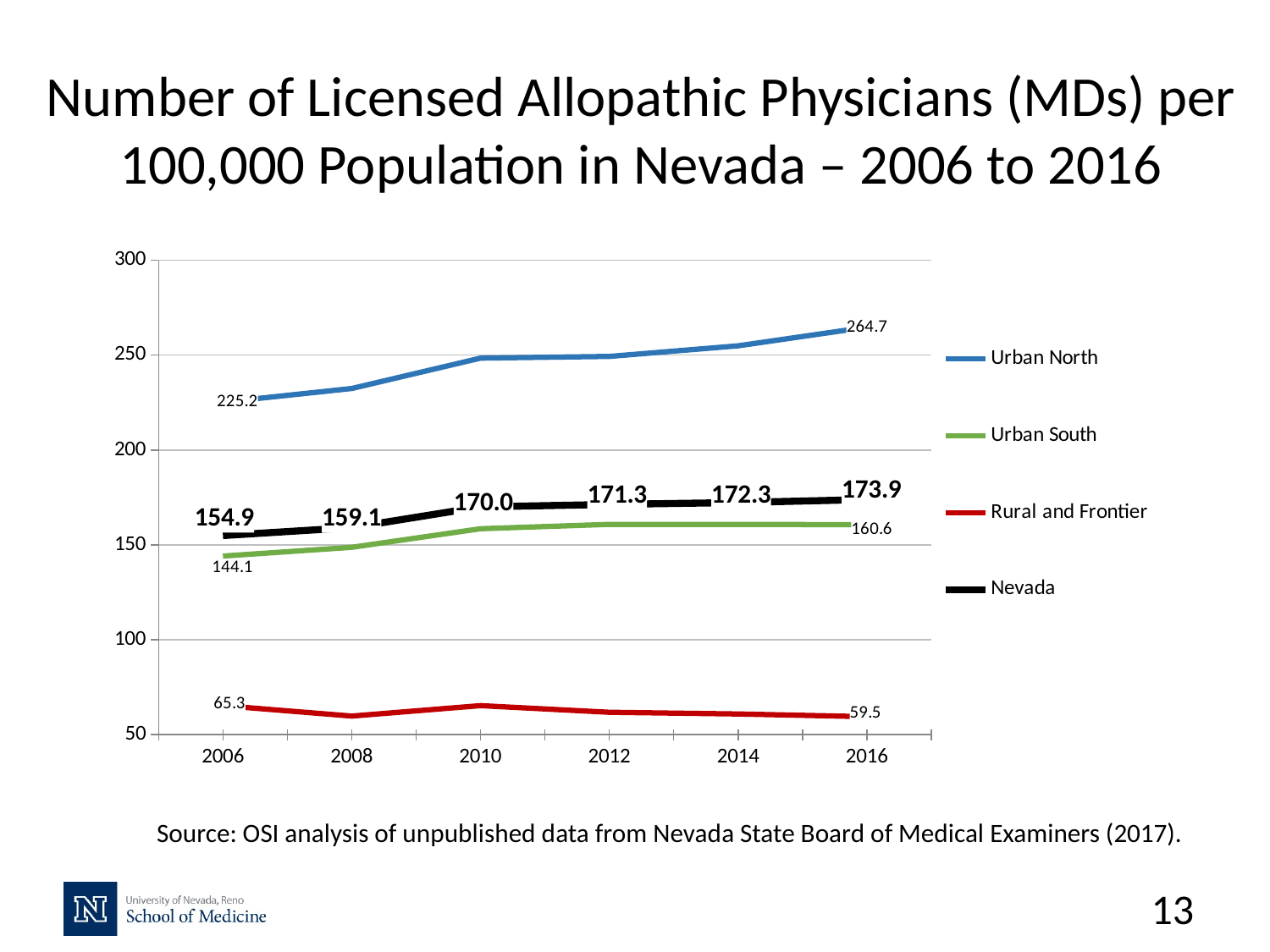
Does the Nevada series rise or fall from 2006 to 2016? Rise What is the value for Nevada in 2016? 173.9 Is the value for Urban North in 2010 greater or less than 200? greater Which series has the lowest value in 2006? Rural and Frontier What is the value for Rural and Frontier in 2016? 59.5 What kind of chart is shown on the slide? Line chart Which is larger in 2016, the Urban South value or the Nevada value? Nevada What is the difference between the Nevada values in 2016 and 2006? 19.0 Which series has the highest value in 2016? Urban North What is the value for Urban South in 2006? 144.1 What is the value for Urban North in 2006? 225.2 How many series does the legend list? 4